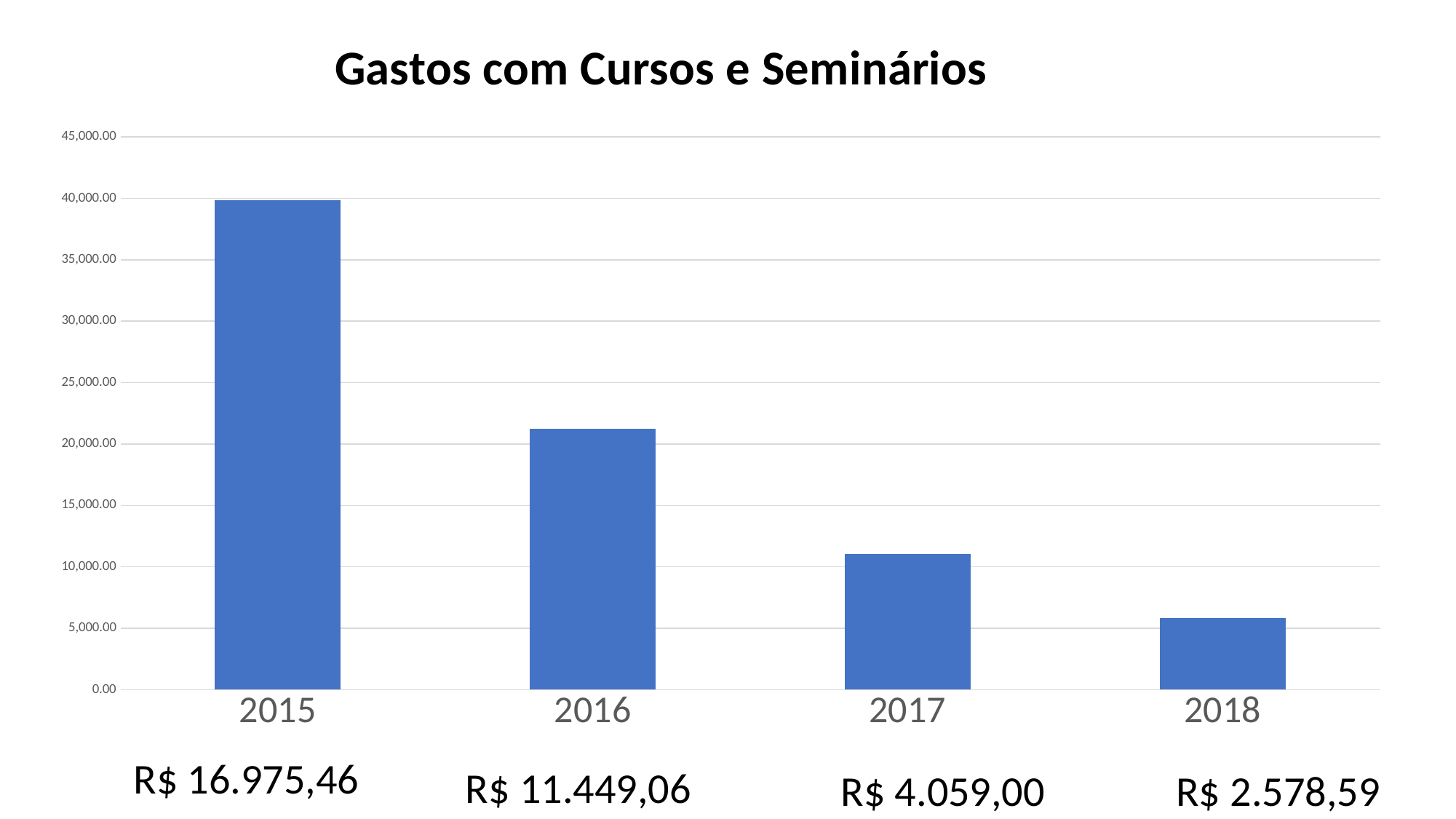
Which year has the highest bar in the chart? 2015 Which year has the larger value, 2016 or 2017? 2016 How many years (categories) are shown in the chart? 4 Is the value for 2015 greater or less than 35,000.00? greater Is the value for 2018 greater or less than 10,000.00? less Is the value for 2017 greater or less than 15,000.00? less What type of chart is shown on the slide? bar chart Which year has the lowest bar in the chart? 2018 What is the highest value shown on the vertical axis? 45,000.00 What is the title of the chart? Gastos com Cursos e Seminários Do the values rise or fall from 2015 to 2018? fall